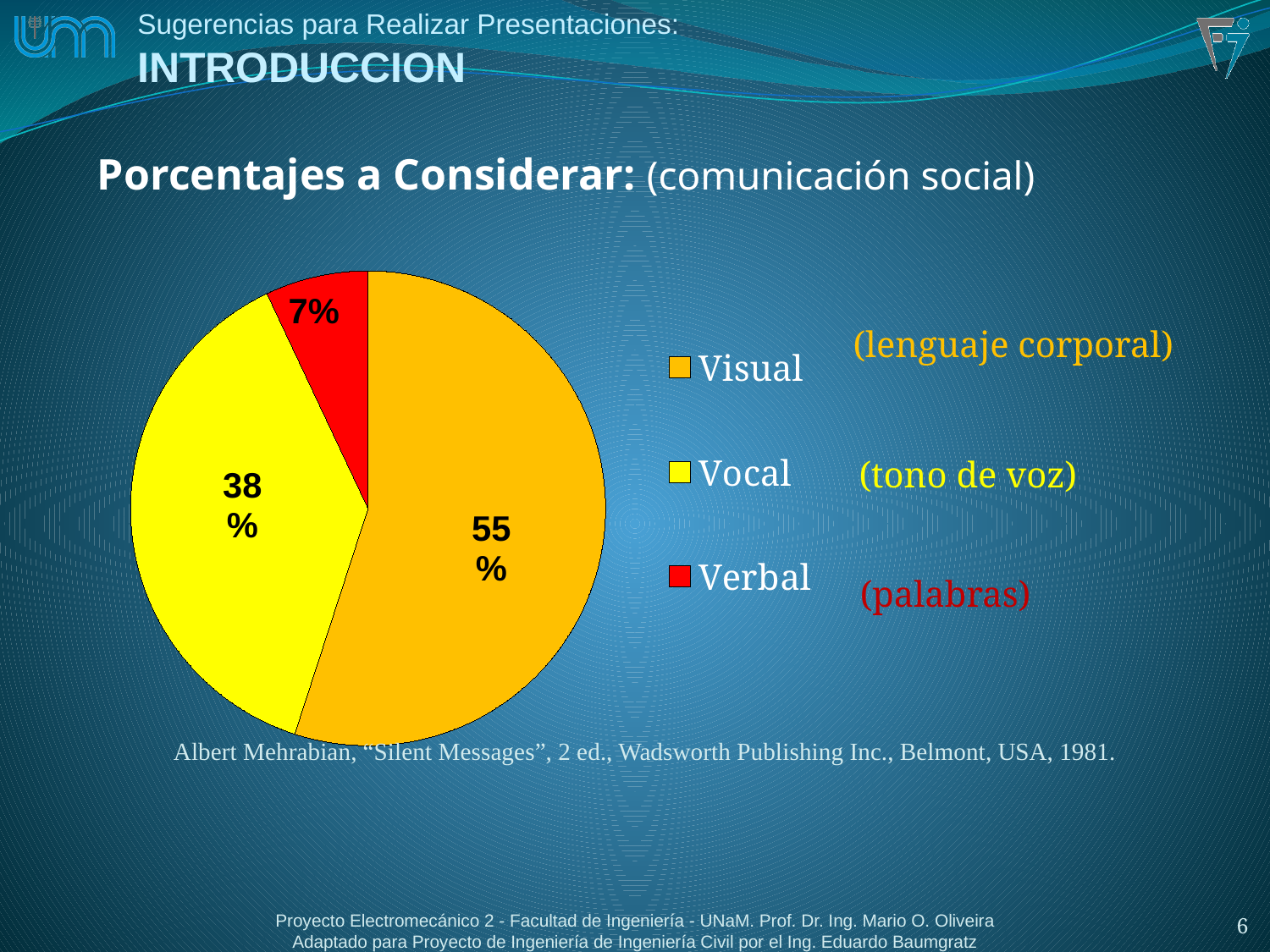
Which category has the smallest share of the pie? Verbal What percentage does the Vocal slice represent? 38% What colour is the Verbal slice? red What percentage does the Verbal slice represent? 7% Which category is shown in yellow in the legend? Vocal What percentage does the Visual slice represent? 55% What type of chart is shown on the slide? pie chart What is the difference in percentage points between the Visual and Vocal slices? 17 Which is larger, the Vocal slice or the Verbal slice? Vocal Which category has the largest share of the pie? Visual What is the difference in percentage points between the Vocal and Verbal slices? 31 How many slices does the pie chart have? 3